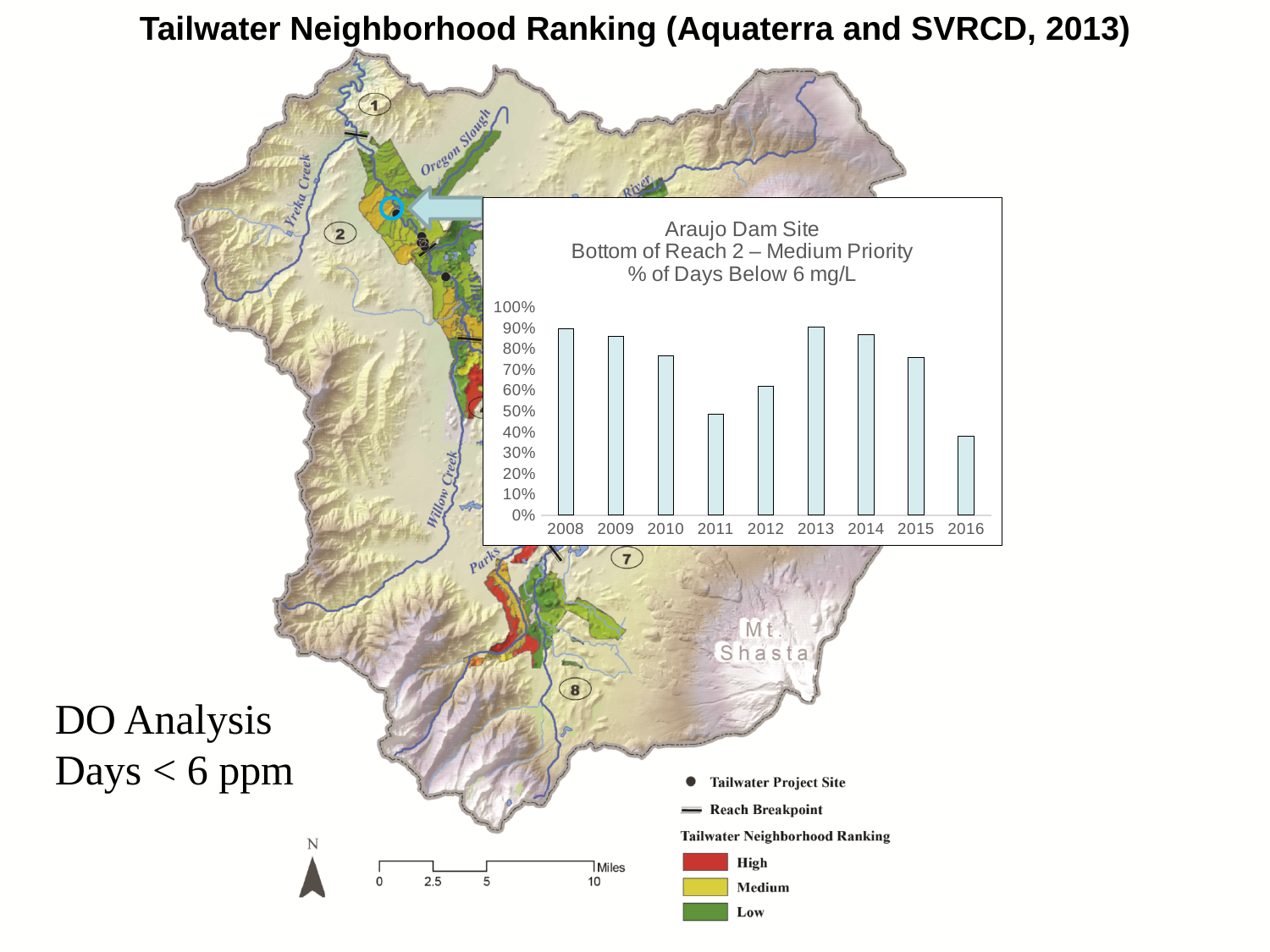
Is the value for 2011 greater or less than 40%? greater Is the value for 2010 greater or less than 70%? greater Which year has the larger value, 2015 or 2016? 2015 Which year has the larger value, 2011 or 2012? 2012 What kind of chart is shown on the slide? bar chart Is the value for 2012 greater or less than 50%? greater How many years are plotted on the chart? 9 Which year has the lowest % of days below 6 mg/L? 2016 Do the values rise or fall from 2013 to 2016? fall Which site does the chart's title say the data is for? Araujo Dam Site